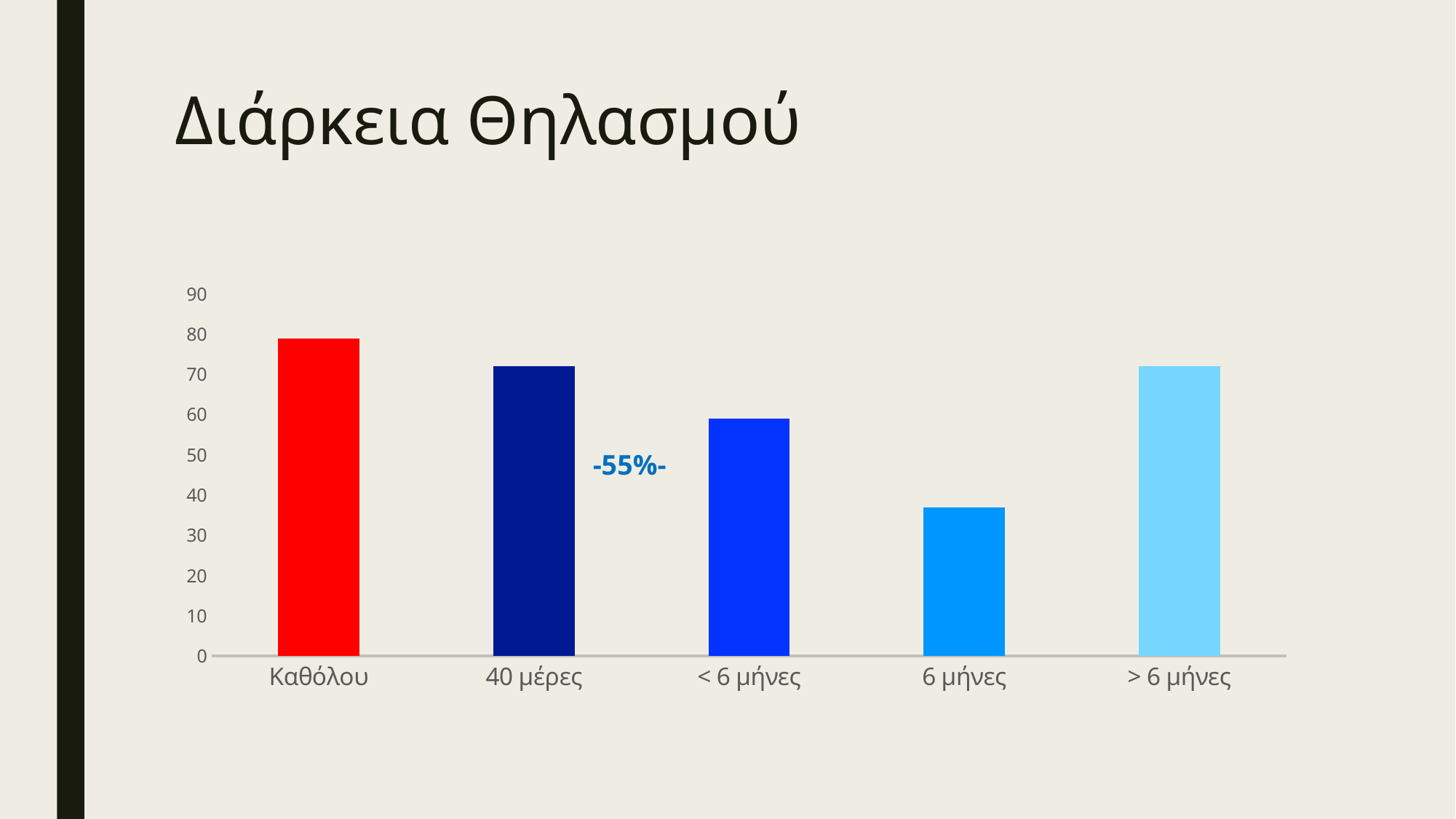
Which is larger, the value for < 6 μήνες or the value for 6 μήνες? < 6 μήνες Is the value for > 6 μήνες greater or less than 60? greater Which category has the lowest bar? 6 μήνες Which category has the highest bar? Καθόλου What is the title of the slide? Διάρκεια Θηλασμού What kind of chart is shown on the slide? bar chart What text annotation is printed between the 40 μέρες and < 6 μήνες bars? -55%- Is the value for 6 μήνες greater or less than 50? less Which is larger, the value for Καθόλου or the value for 6 μήνες? Καθόλου Is the value for < 6 μήνες greater or less than 50? greater How many categories are shown on the x axis of the chart? 5